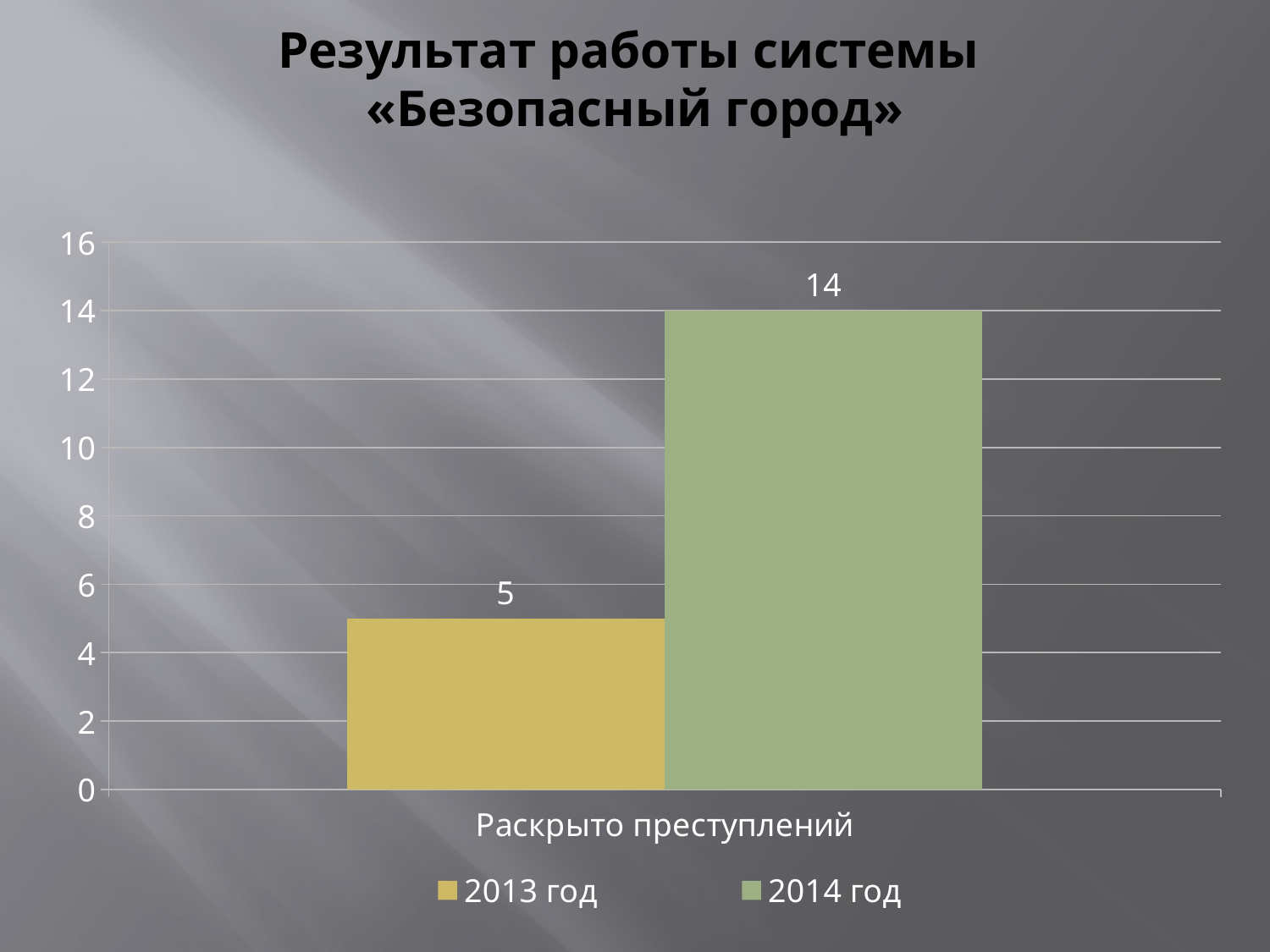
Which series has the higher value, 2013 год or 2014 год? 2014 год What is the value for 2014 год in the chart? 14 What is the title of the slide? Результат работы системы «Безопасный город» Is the value for 2013 год greater or less than 6? less What kind of chart is shown on the slide? bar chart Which series has the lowest value in the chart? 2013 год What is the difference between the values for 2014 год and 2013 год? 9 How many categories are shown on the x axis? 1 Is the value for 2014 год greater or less than 10? greater How many series does the legend list? 2 What is the value for 2013 год in the chart? 5 What is the category label on the x axis? Раскрыто преступлений